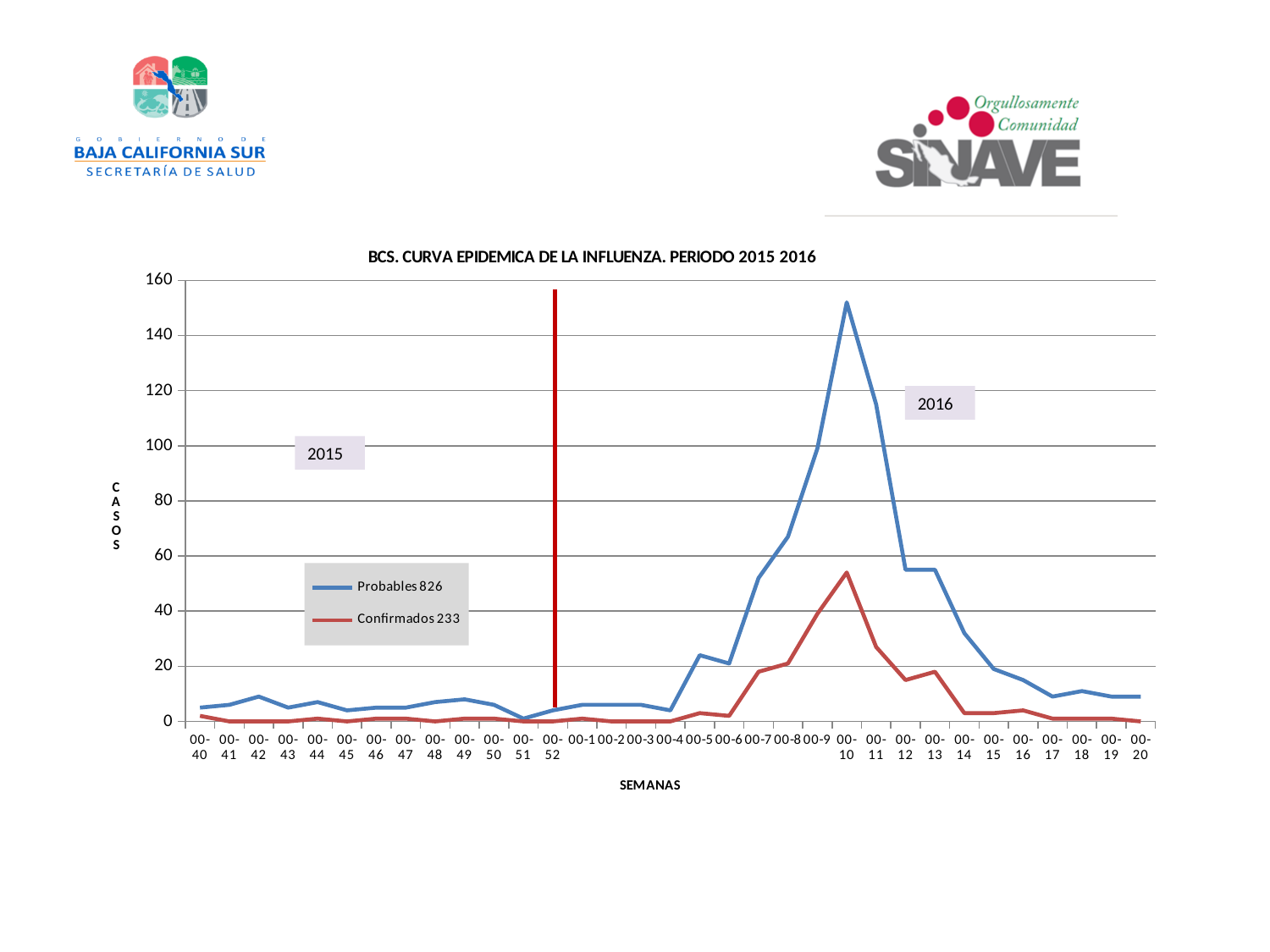
What are the two series named in the legend? Probables 826 and Confirmados 233 In which week does the Probables series reach its highest value? 00-10 What kind of chart is shown on the slide? line chart Is the value for Confirmados in week 00-14 greater or less than 20? less What is the title of the chart? BCS. CURVA EPIDEMICA DE LA INFLUENZA. PERIODO 2015 2016 Is the value for Probables in week 00-10 greater or less than 140? greater How many series does the legend list? 2 Do the Probables values rise or fall from week 00-10 to week 00-14? fall How many weeks are plotted along the x axis? 33 In which week does the Confirmados series reach its highest value? 00-10 Is the value for Confirmados in week 00-10 greater or less than 40? greater In week 00-10, which series has the larger value, Probables or Confirmados? Probables